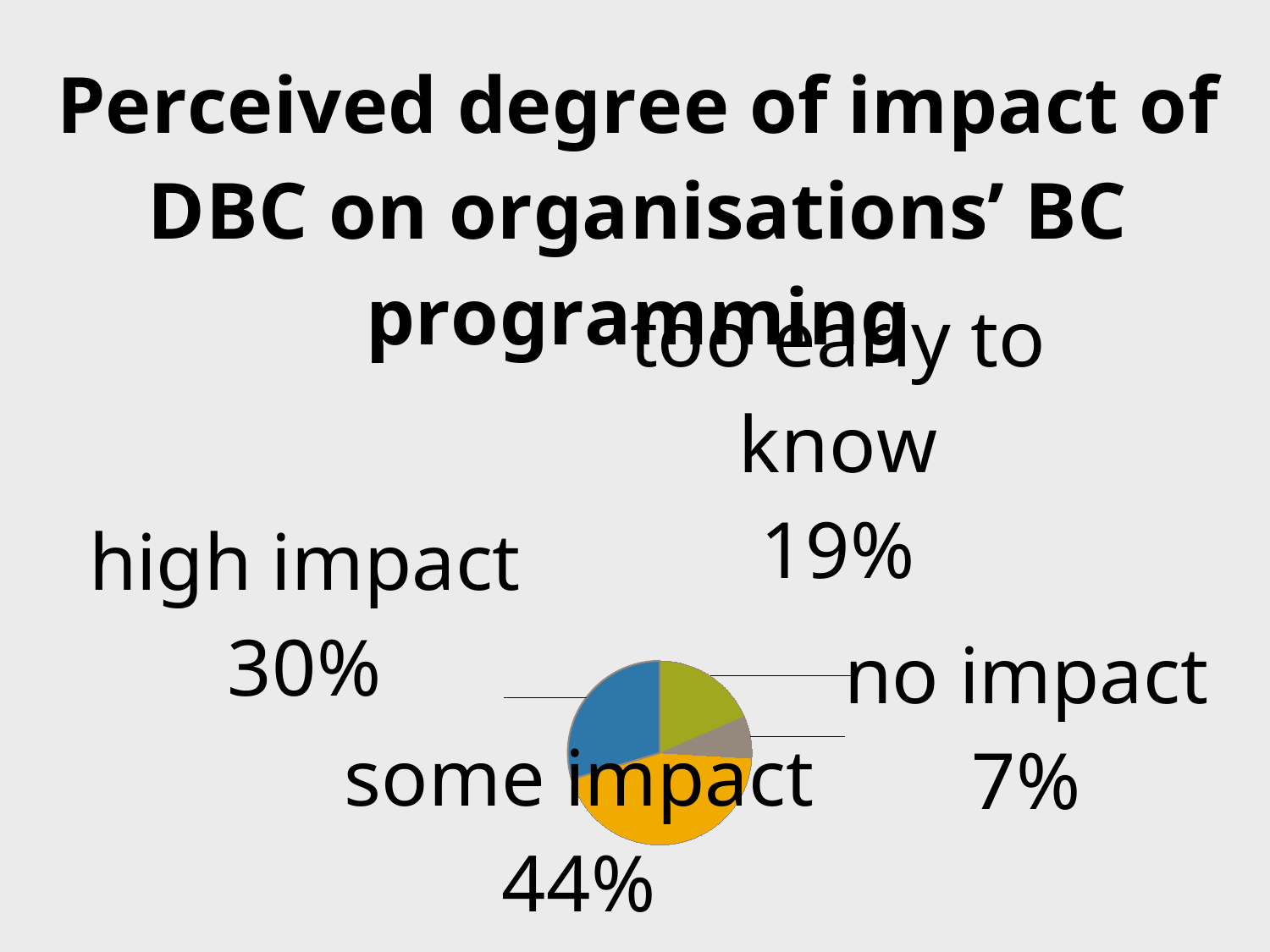
How many slices does the pie chart have? 4 Which category has the largest share of the pie? some impact What percentage of respondents reported no impact? 7% What percentage of respondents said it was too early to know? 19% What is the title of the chart? Perceived degree of impact of DBC on organisations' BC programming What is the difference in percentage points between some impact and high impact? 14 What colour is the slice for some impact? yellow What percentage of respondents reported high impact? 30% Which category has the smallest share of the pie? no impact What percentage of respondents reported some impact? 44% Which is larger, the share for high impact or the share for too early to know? high impact What type of chart is shown on the slide? pie chart